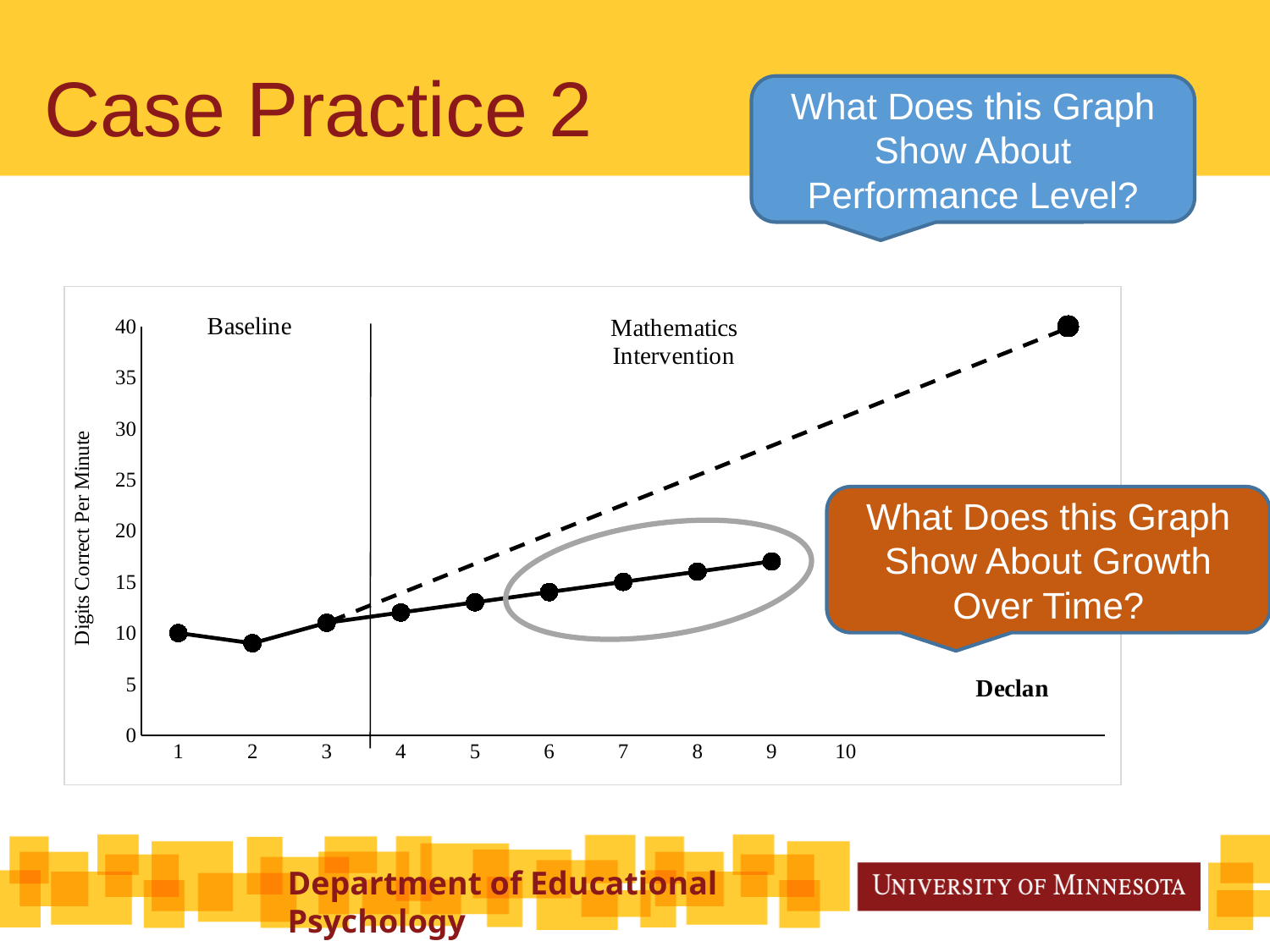
What value does the dashed goal line reach at its endpoint? 40 Do the values on the solid line rise or fall from x = 3 to x = 9? rise What is the value of the solid line at x = 7? 15 What are the two phases labelled on the chart? Baseline and Mathematics Intervention Is the value of the solid line at x = 2 greater or less than 10? less Is the value of the solid line at x = 9 greater or less than 15? greater What is the y-axis label of the chart? Digits Correct Per Minute At which x value is the solid line highest? 9 How many data points are plotted on the solid line? 9 What is the value of the solid line at x = 1? 10 What kind of chart is shown on the slide? line chart At which x value is the solid line lowest? 2